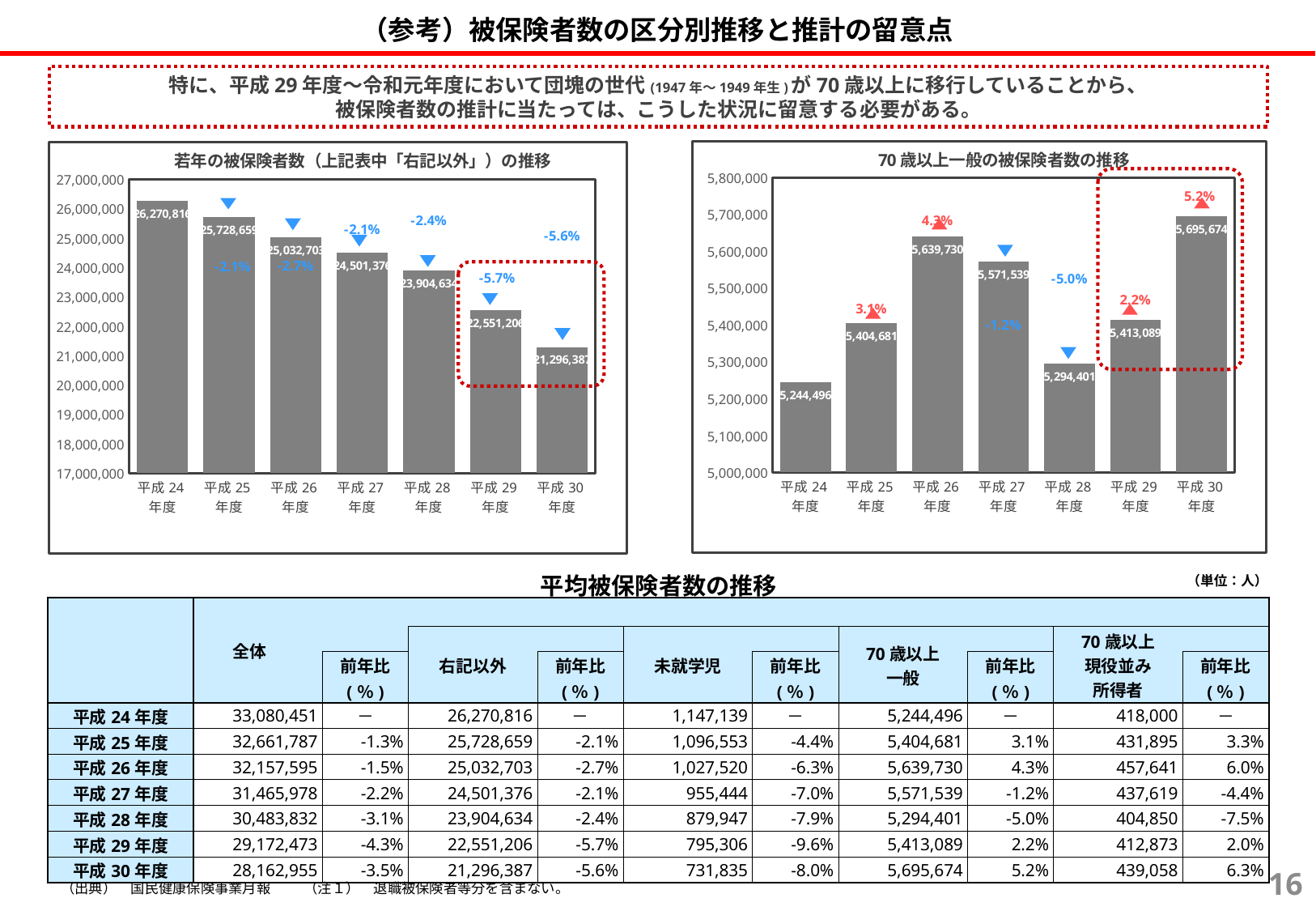
In the left chart (若年の被保険者数の推移), what is the difference between the values for 平成28年度 and 平成29年度? 1,353,428 In the left chart (若年の被保険者数の推移), how many fiscal years are plotted? 7 What type of chart is the right chart (70歳以上一般の被保険者数の推移)? bar chart In the right chart (70歳以上一般の被保険者数の推移), what is the year-on-year change shown for 平成30年度? 5.2% In the right chart (70歳以上一般の被保険者数の推移), which fiscal year has the highest value? 平成30年度 In the right chart (70歳以上一般の被保険者数の推移), what is the value for 平成26年度? 5,639,730 In the left chart (若年の被保険者数の推移), what is the value for 平成24年度? 26,270,816 In the right chart (70歳以上一般の被保険者数の推移), which is larger, the value for 平成27年度 or 平成28年度? 平成27年度 In the left chart (若年の被保険者数の推移), what is the year-on-year change shown for 平成29年度? -5.7% In the right chart (70歳以上一般の被保険者数の推移), which fiscal year has the lowest value? 平成24年度 In the left chart (若年の被保険者数の推移), do the values rise or fall from 平成24年度 to 平成30年度? fall In the left chart (若年の被保険者数の推移), what is the value for 平成30年度? 21,296,387